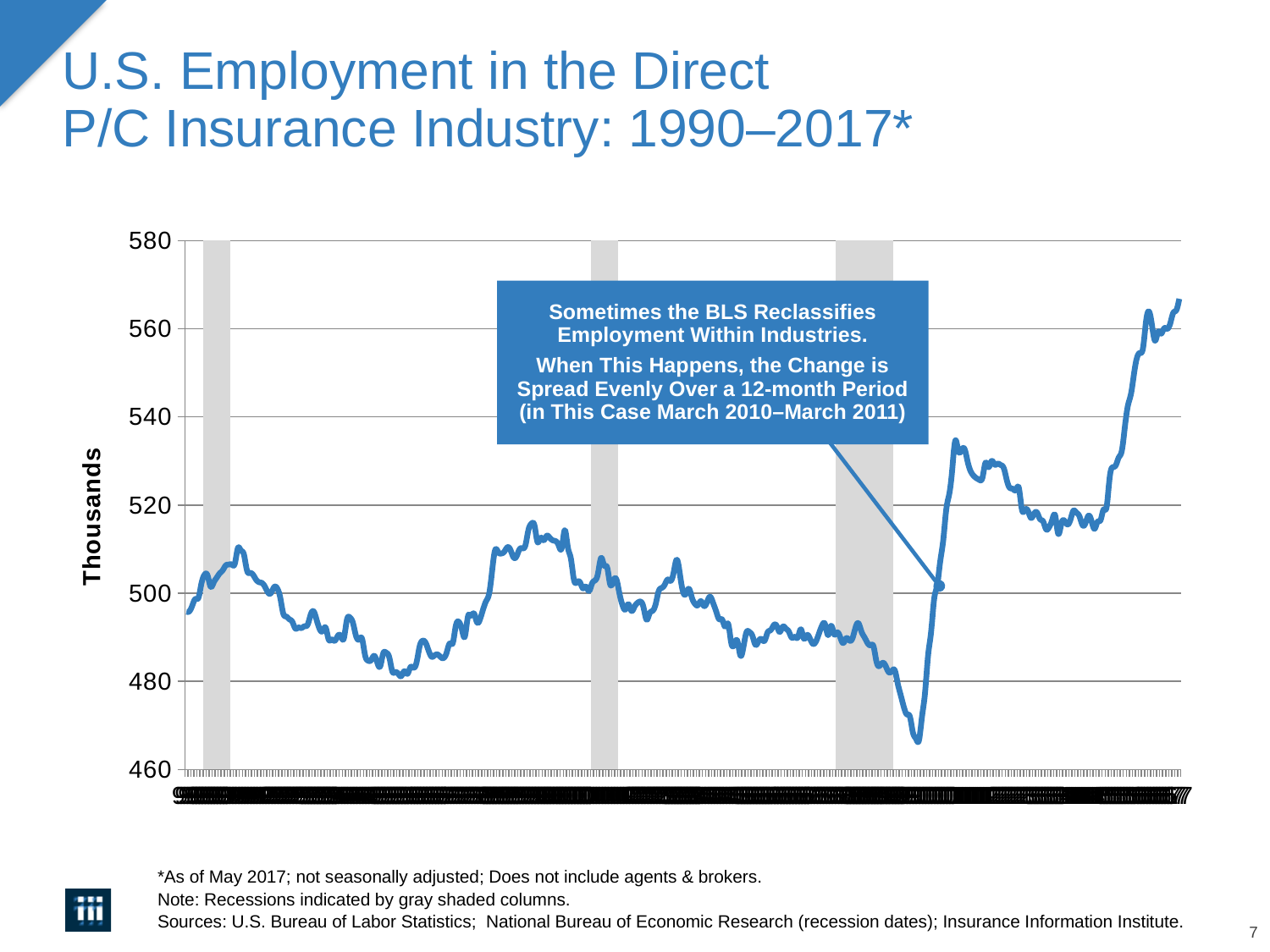
What is the title of the chart on the slide? U.S. Employment in the Direct P/C Insurance Industry: 1990–2017* Is the value at the start of the series (the left-most point) greater or less than 480? greater Is the lowest point of the line greater or less than 480? less Comparing the start of the series to the end of the series, does employment rise or fall overall? rise Which is larger, the value at the right-most end of the line or the value at the left-most start of the line? the right-most end What is the highest tick value shown on the vertical axis? 580 Is the lowest point of the line greater or less than 460? greater How many data series are plotted on the chart? 1 What is the label on the vertical axis of the chart? Thousands What kind of chart is shown on the slide? line chart